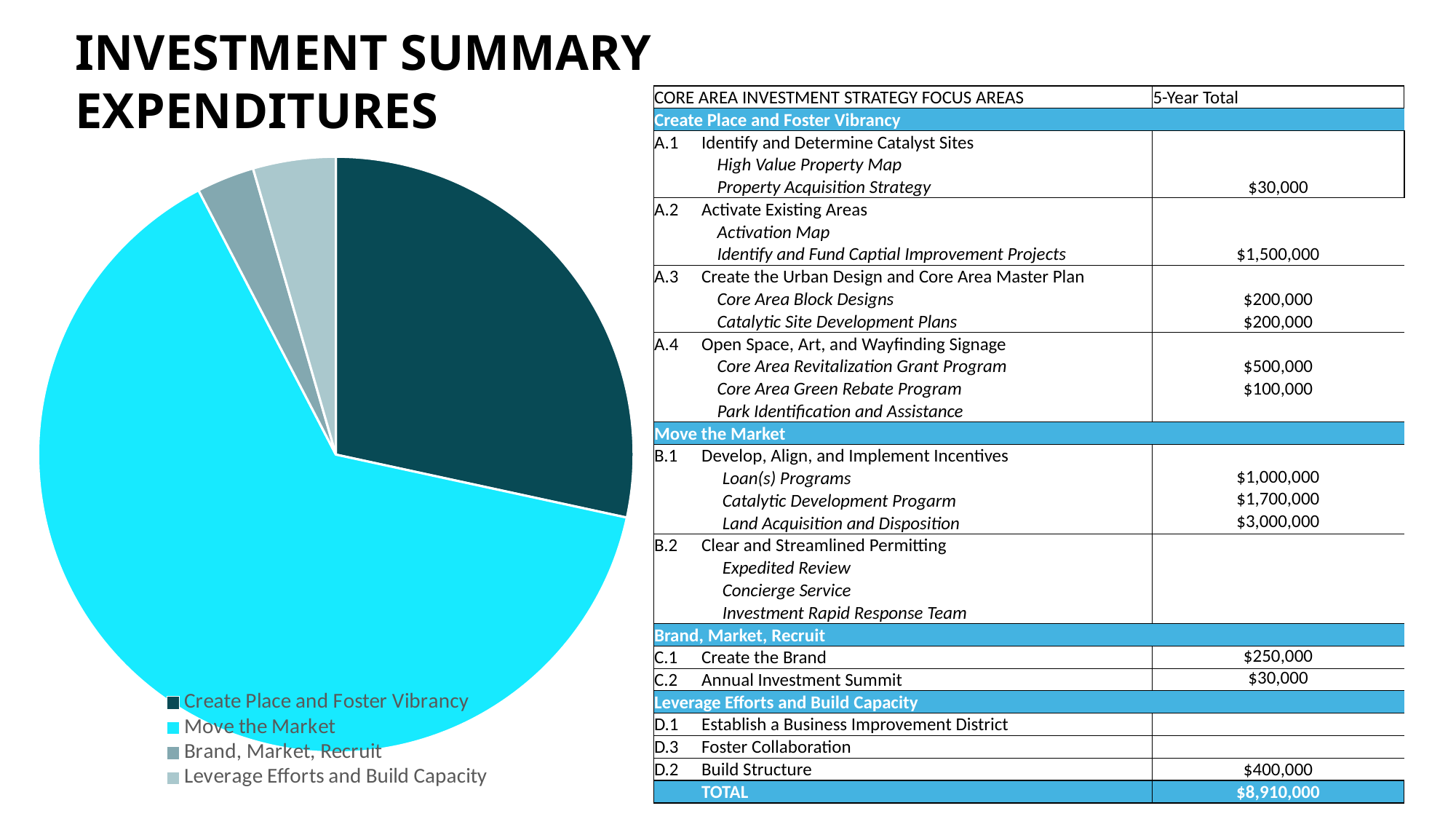
Which slice is larger in the pie chart: Create Place and Foster Vibrancy or Move the Market? Move the Market Does the Move the Market slice take up more or less than half of the pie chart? more How many entries does the pie chart's legend list? 4 Which category has the largest slice of the pie chart? Move the Market Which category has the smallest slice of the pie chart? Brand, Market, Recruit How many slices does the pie chart have? 4 What kind of chart is shown on the slide? pie chart Which slice is larger in the pie chart: Move the Market or Leverage Efforts and Build Capacity? Move the Market Which slice is larger in the pie chart: Create Place and Foster Vibrancy or Brand, Market, Recruit? Create Place and Foster Vibrancy Which legend entry is listed first in the pie chart's legend? Create Place and Foster Vibrancy Which category is shown in bright cyan in the pie chart? Move the Market